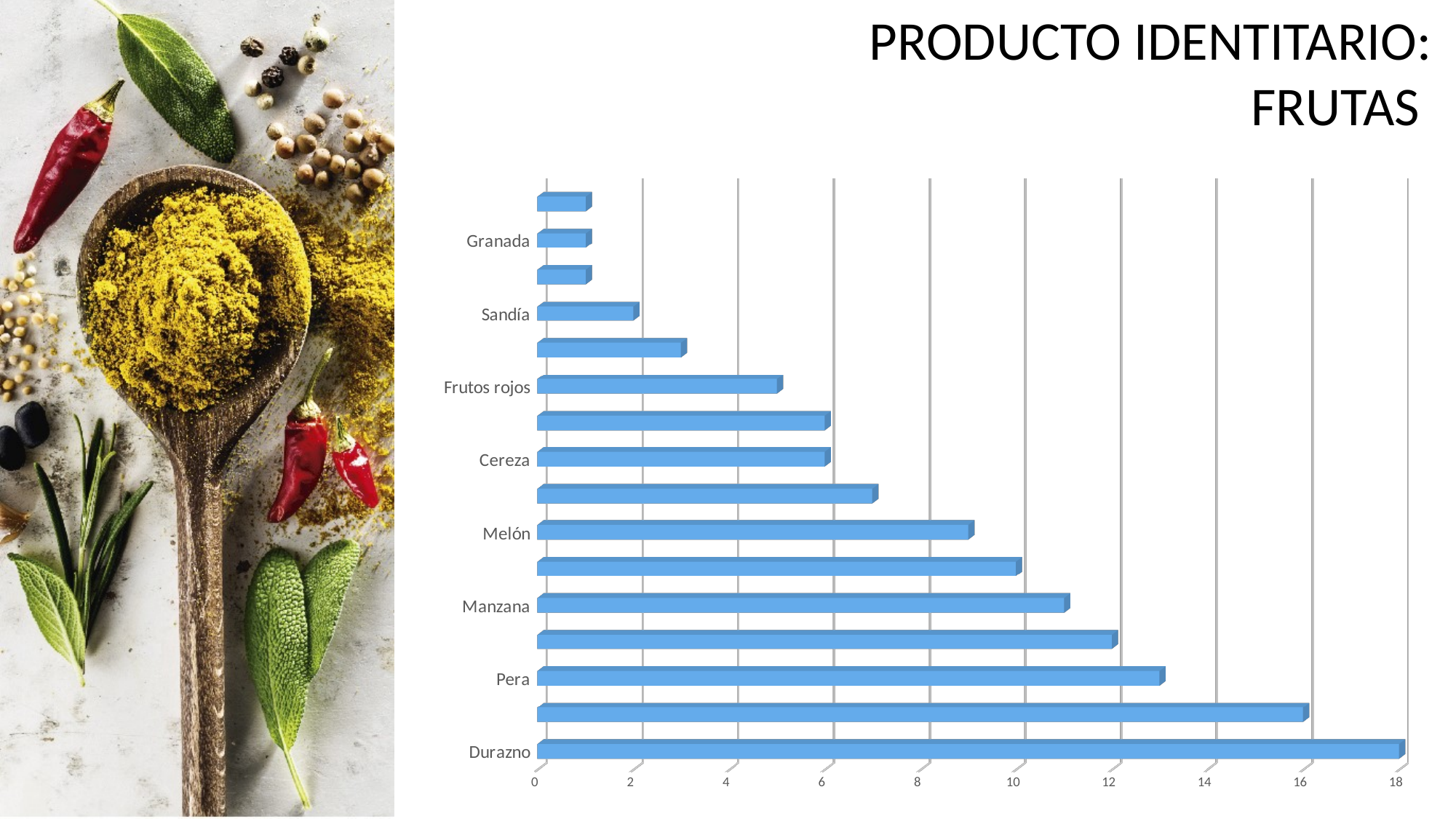
How many bars are plotted in the chart? 16 What is the value for Cereza? 6 What is the title of the slide containing the chart? PRODUCTO IDENTITARIO: FRUTAS What type of chart is shown on the slide? Bar chart What is the value for Sandía? 2 Is the value for Frutos rojos greater or less than 4? greater Is the value for Pera greater or less than 12? greater Which has a larger value, Pera or Manzana? Pera What is the value for Durazno? 18 Which category has the highest value? Durazno Is the value for Melón greater or less than 10? less What is the difference between the values for Durazno and Cereza? 12